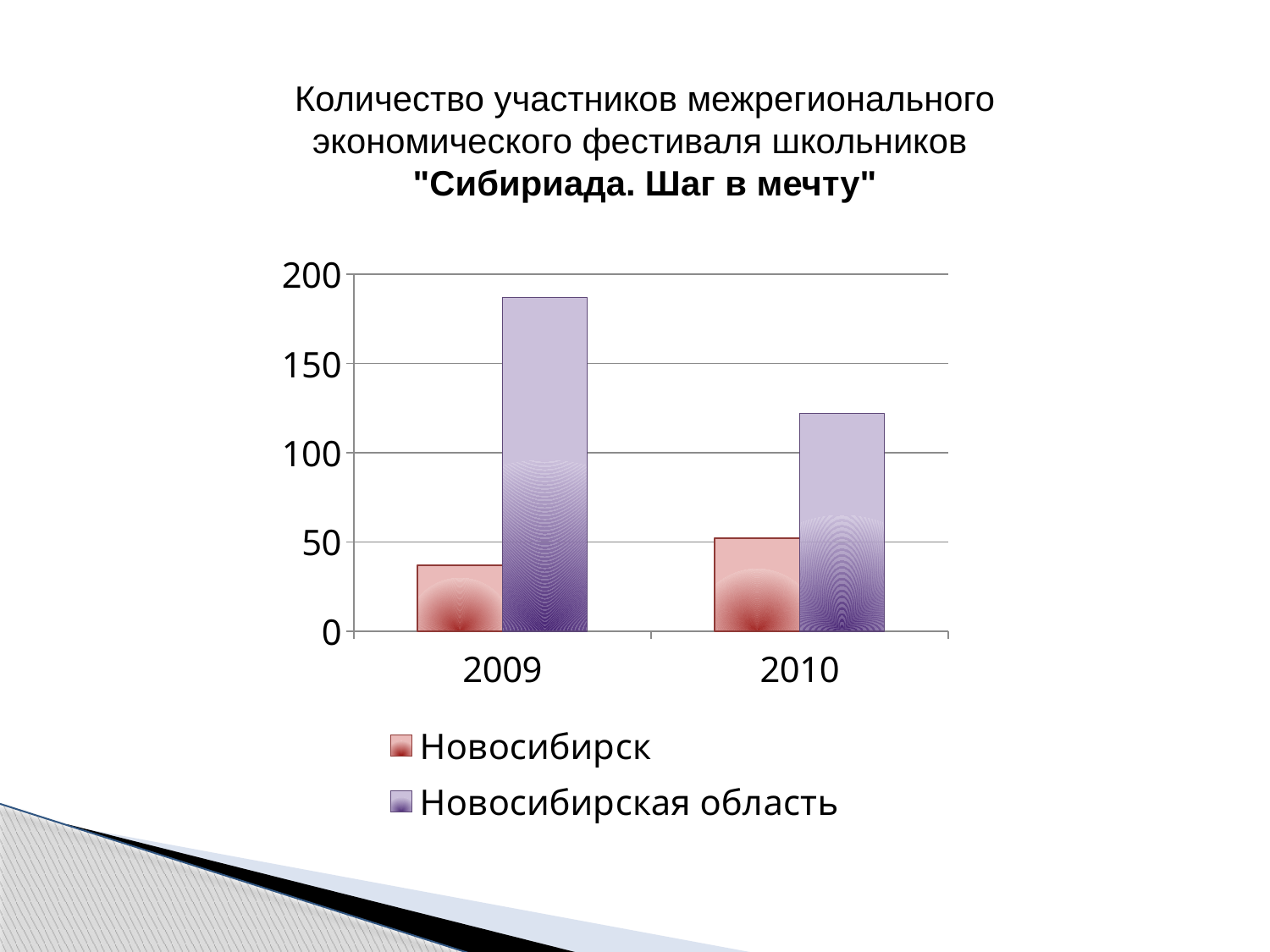
Is the value for Новосибирская область in 2009 greater or less than 150? greater Is the value for Новосибирск in 2010 greater or less than 100? less How many series does the legend list? 2 Is the value for Новосибирская область in 2010 greater or less than 150? less Which series does the legend list first? Новосибирск Which is larger: Новосибирская область in 2009 or Новосибирская область in 2010? Новосибирская область in 2009 How many years are shown on the x axis? 2 Does the value for Новосибирск rise or fall from 2009 to 2010? rise Which series is shown in purple? Новосибирская область What kind of chart is shown on the slide? bar chart Which bar is the highest in the chart? Новосибирская область in 2009